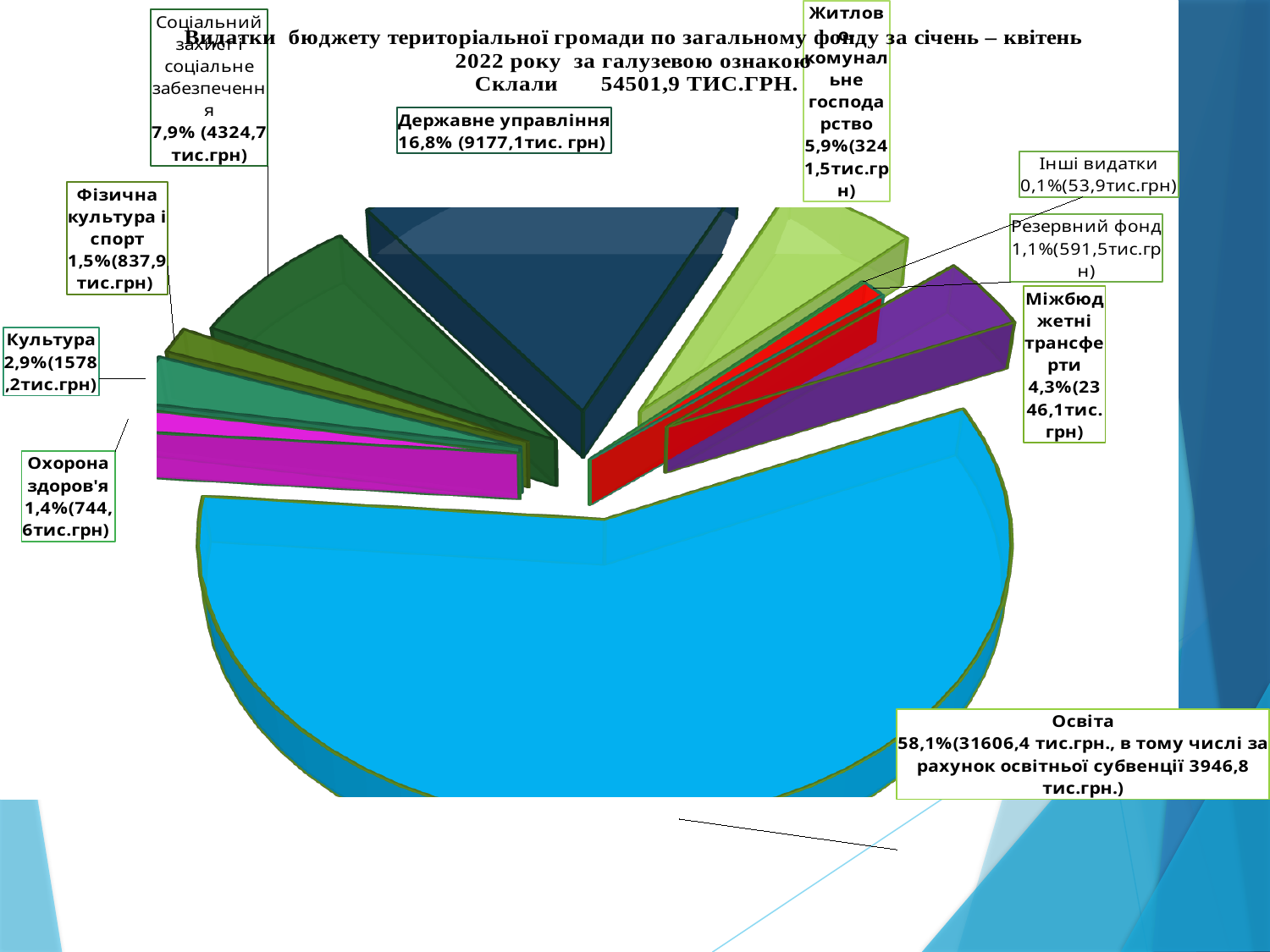
Which category has the largest share of the pie? Освіта What is the difference in percentage points between Державне управління and Соціальний захист і соціальне забезпечення? 8,9 How many categories are shown in the pie chart? 10 Which is larger, the share for Культура or the share for Фізична культура і спорт? Культура What total amount of expenditures is stated in the chart title? 54501,9 тис.грн What is the amount shown for Міжбюджетні трансферти? 2346,1 тис. грн What percentage is shown for Житлово-комунальне господарство? 5,9% What share of the pie does Освіта account for? 58,1% What percentage is shown for Соціальний захист і соціальне забезпечення? 7,9% Which category has the smallest share of the pie? Інші видатки What is the amount shown for Державне управління? 9177,1 тис. грн What kind of chart is shown on the slide? Pie chart